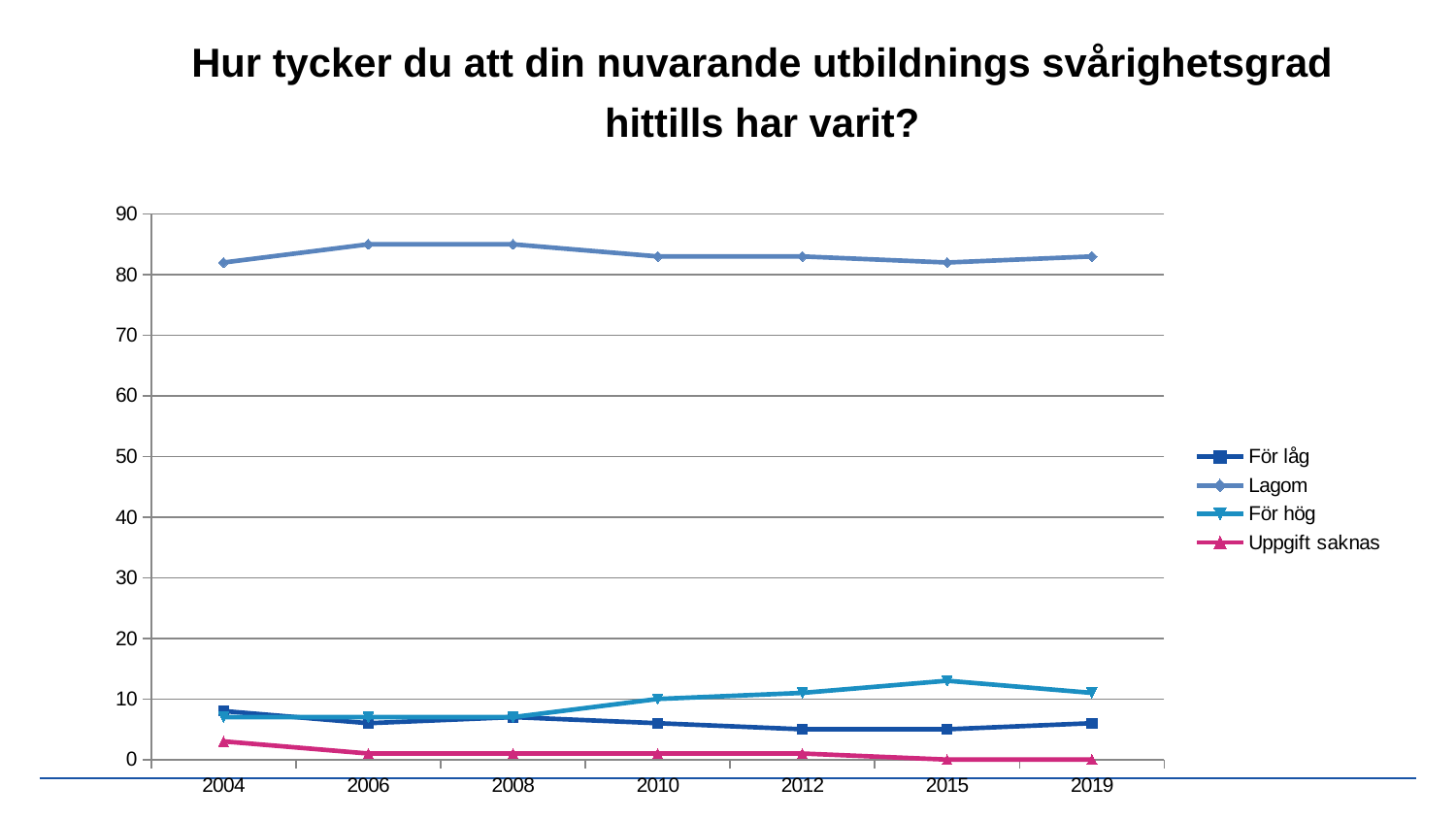
Which is larger in 2010, Lagom or För hög? Lagom What kind of chart is shown on the slide? line chart Is the value for Lagom in 2006 greater or less than 80? greater Which is larger in 2015, För hög or För låg? För hög Is the value for För hög in 2015 greater or less than 10? greater How many series does the legend list? 4 What is the title of the chart? Hur tycker du att din nuvarande utbildnings svårighetsgrad hittills har varit? Which series has the highest values across all years? Lagom Is the value for För låg in 2012 greater or less than 10? less Which series has the lowest value in 2019? Uppgift saknas Does the För hög series rise or fall from 2008 to 2015? rise How many years are shown along the x axis? 7